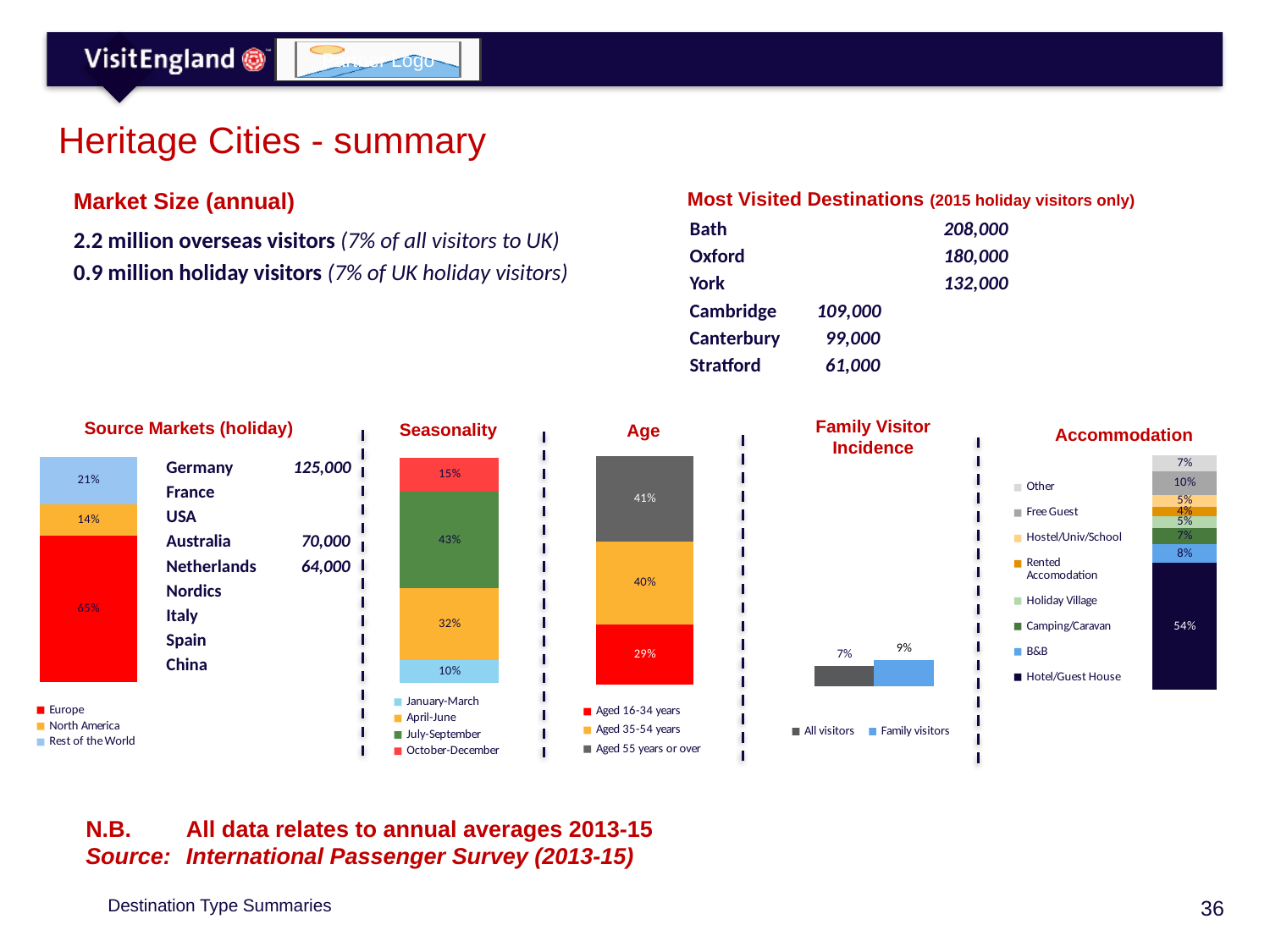
How many series does the legend of the Family Visitor Incidence chart list? 2 In the Seasonality chart, what is the difference between the April-June share and the October-December share? 17% In the Age chart, which is larger: the share aged 35-54 years or the share aged 16-34 years? Aged 35-54 years In the Source Markets (holiday) chart, which region has the smallest share? North America In the Seasonality chart, what percentage of visits occur in July-September? 43% What type of chart is the Seasonality chart? Stacked bar chart In the Accommodation chart, what share of visitors stay in a Hotel/Guest House? 54% In the Seasonality chart, which period has the lowest share of visits? January-March In the Family Visitor Incidence chart, what is the value for Family visitors? 9% In the Source Markets (holiday) chart, what share of holiday visitors comes from Europe? 65% In the Age chart, what percentage of visitors are aged 16-34 years? 29% In the Accommodation chart, what is the value for B&B? 8%